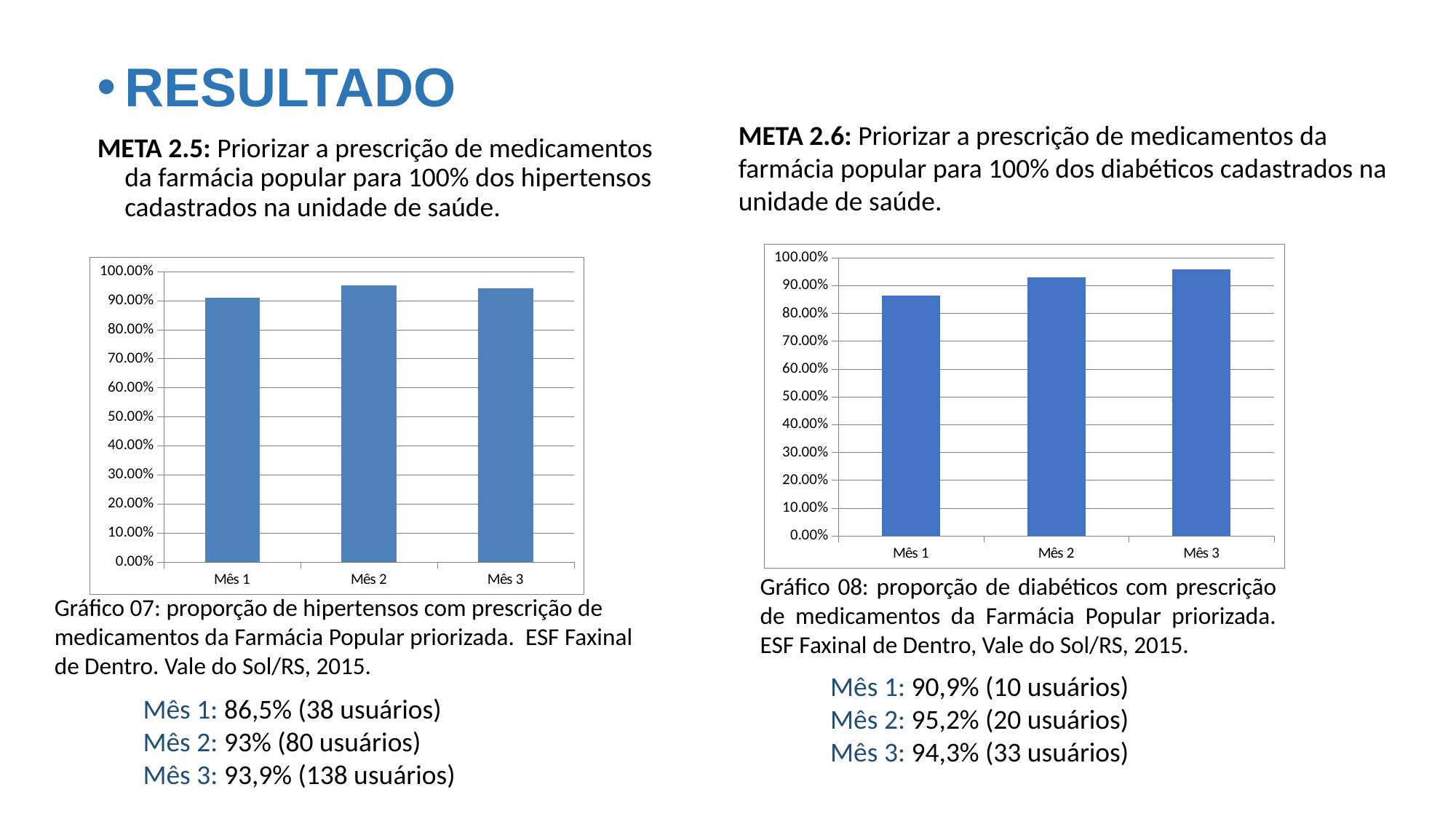
In the left chart (Gráfico 07), which month has the lowest bar? Mês 1 In the right chart (Gráfico 08), which month has the lowest bar? Mês 1 In the right chart (Gráfico 08), which month has the highest bar? Mês 3 In the right chart (Gráfico 08), which bar is taller, Mês 1 or Mês 3? Mês 3 What is the highest value shown on the y axis of the left chart (Gráfico 07)? 100.00% In the right chart (Gráfico 08), is the bar for Mês 3 greater or less than 90.00%? greater In the right chart (Gráfico 08), is the bar for Mês 1 greater or less than 90.00%? less In the left chart (Gráfico 07), which bar is taller, Mês 1 or Mês 2? Mês 2 In the right chart (Gráfico 08), do the bars rise or fall from Mês 1 to Mês 3? rise How many categories are shown on the x axis of the right chart (Gráfico 08)? 3 What kind of chart is the left chart (Gráfico 07)? bar chart In the left chart (Gráfico 07), is the bar for Mês 2 greater or less than 90.00%? greater